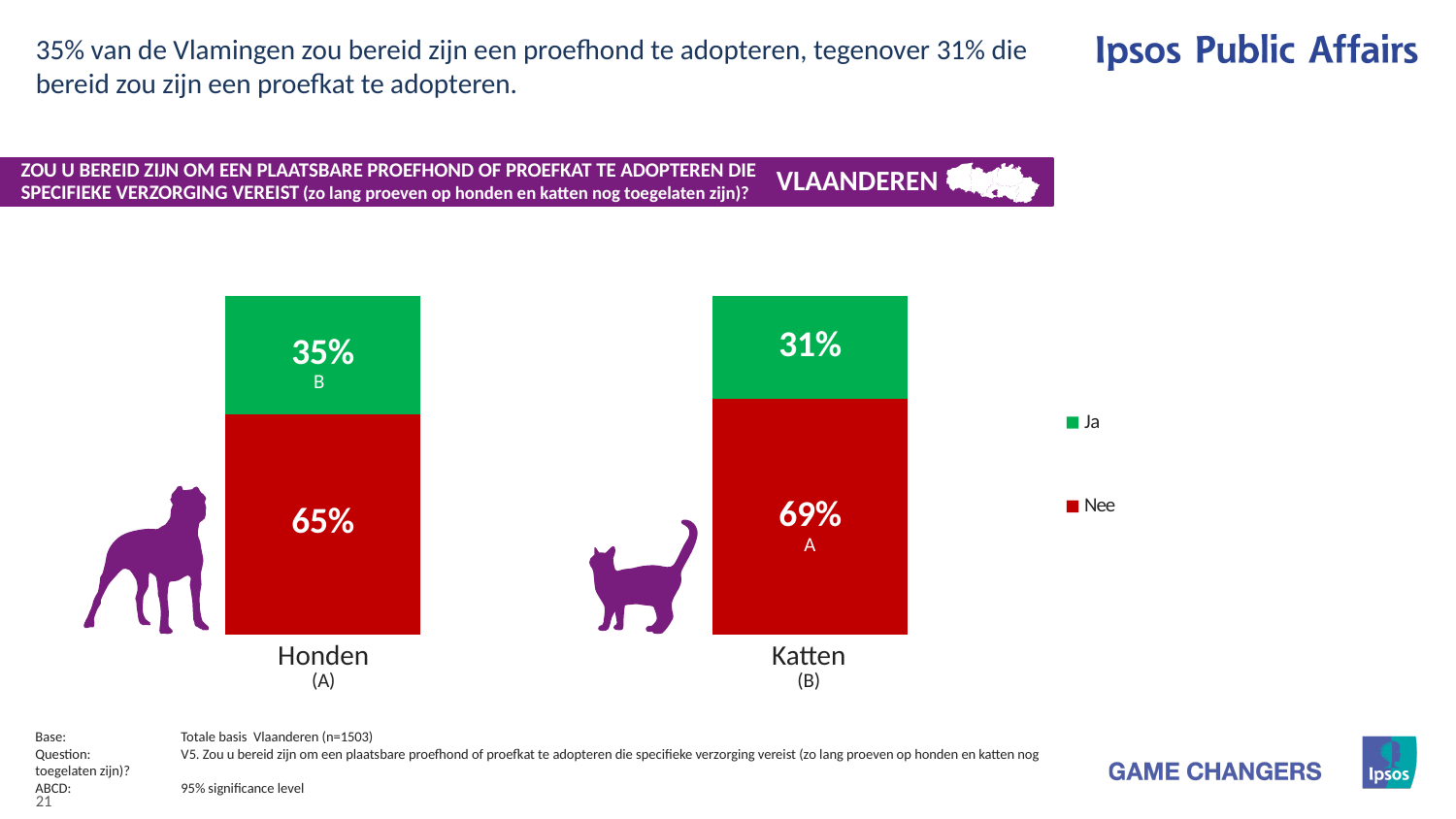
What percentage of respondents answered 'Ja' for Katten? 31% What percentage of respondents answered 'Nee' for Honden? 65% What is the total of the stacked bar for Honden? 100% What percentage of respondents answered 'Nee' for Katten? 69% What is the difference between the 'Ja' values for Honden and Katten? 4% What is the difference between the 'Nee' values for Katten and Honden? 4% What kind of chart is shown on the slide? Stacked bar chart Which category has the highest 'Nee' value? Katten How many categories are shown on the x axis? 2 Which category has the higher 'Ja' share, Honden or Katten? Honden How many series does the legend list? 2 What percentage of respondents answered 'Ja' for Honden? 35%